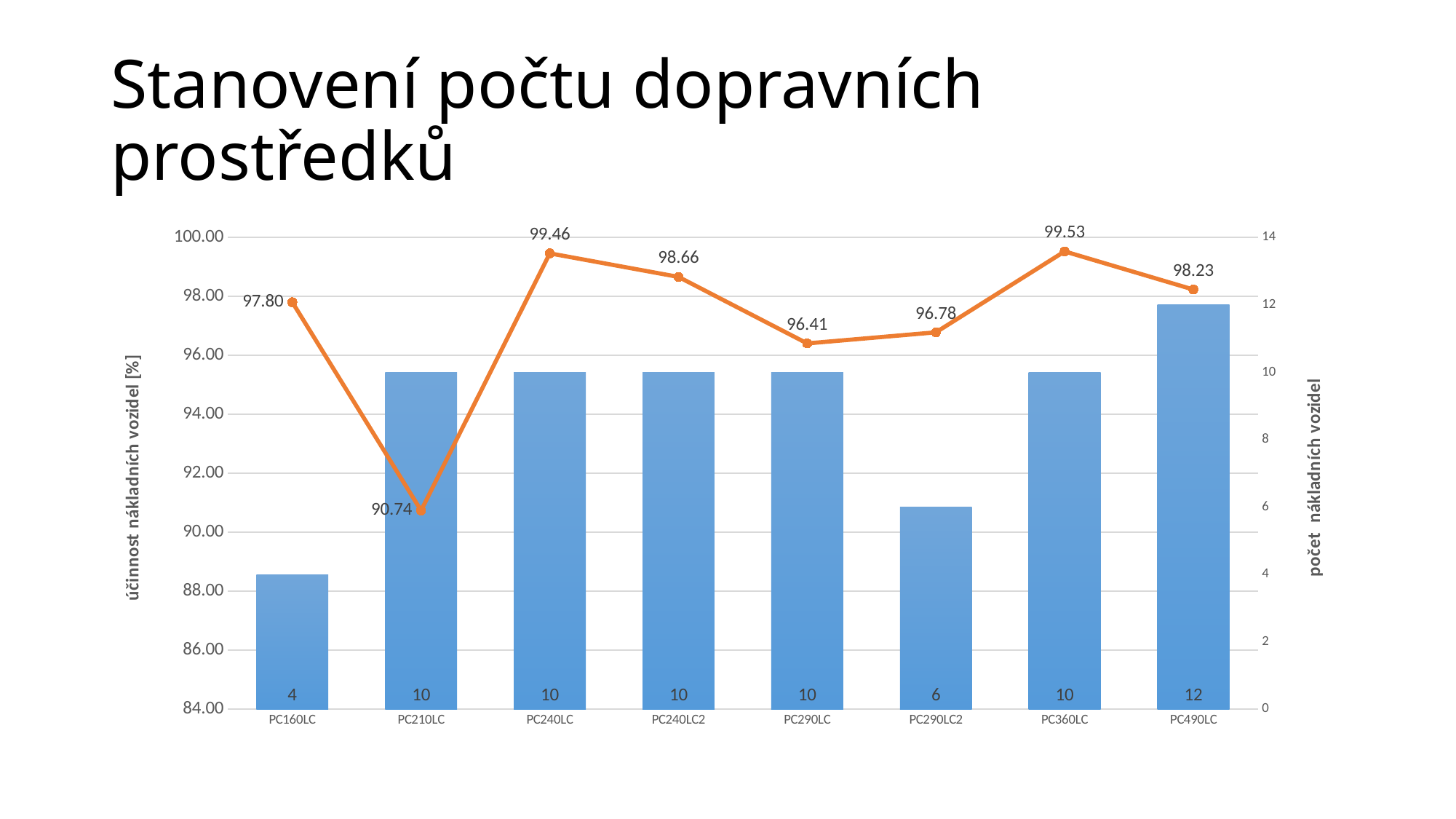
Which category has the highest number of trucks (tallest bar)? PC490LC What is the label of the left vertical axis? účinnost nákladních vozidel [%] How many categories are shown on the x axis? 8 What is the efficiency value for PC360LC? 99.53 What is the label of the right vertical axis? počet nákladních vozidel What is the efficiency (účinnost) value for PC210LC? 90.74 Which category has the lowest efficiency value on the line? PC210LC How many trucks (počet nákladních vozidel) are shown for PC490LC? 12 What kind of chart is this? Combined bar and line chart What is the difference between the efficiency values for PC240LC and PC290LC? 3.05 Which has a higher efficiency value, PC160LC or PC290LC2? PC160LC Which category has the lowest number of trucks? PC160LC